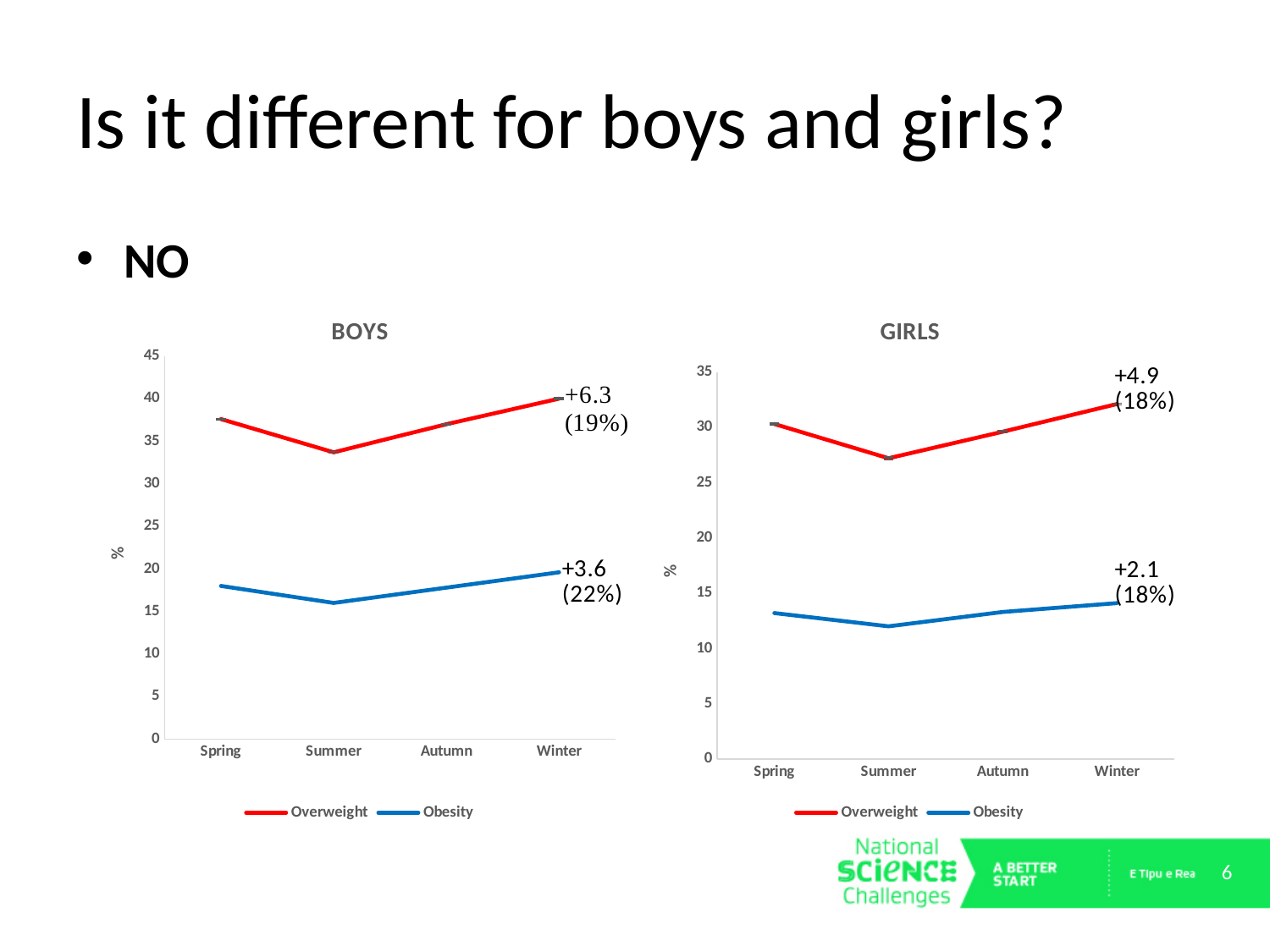
In the BOYS chart, in which season is the Overweight line at its lowest? Summer What kind of chart is the BOYS chart? line chart In the GIRLS chart, is the Obesity value for Winter greater or less than 15? less How many seasons are shown on the x axis of the BOYS chart? 4 In the BOYS chart, does the Overweight line rise or fall from Summer to Winter? rise In the GIRLS chart, is the Overweight value for Summer greater or less than 25? greater In the GIRLS chart, in which season is the Overweight line at its highest? Winter In the BOYS chart, is the Obesity value for Spring greater or less than 20? less How many series does the legend of the GIRLS chart list? 2 In the GIRLS chart, which series is higher in Winter, Overweight or Obesity? Overweight What annotation is printed next to the end of the Obesity line in the BOYS chart? +3.6 (22%)